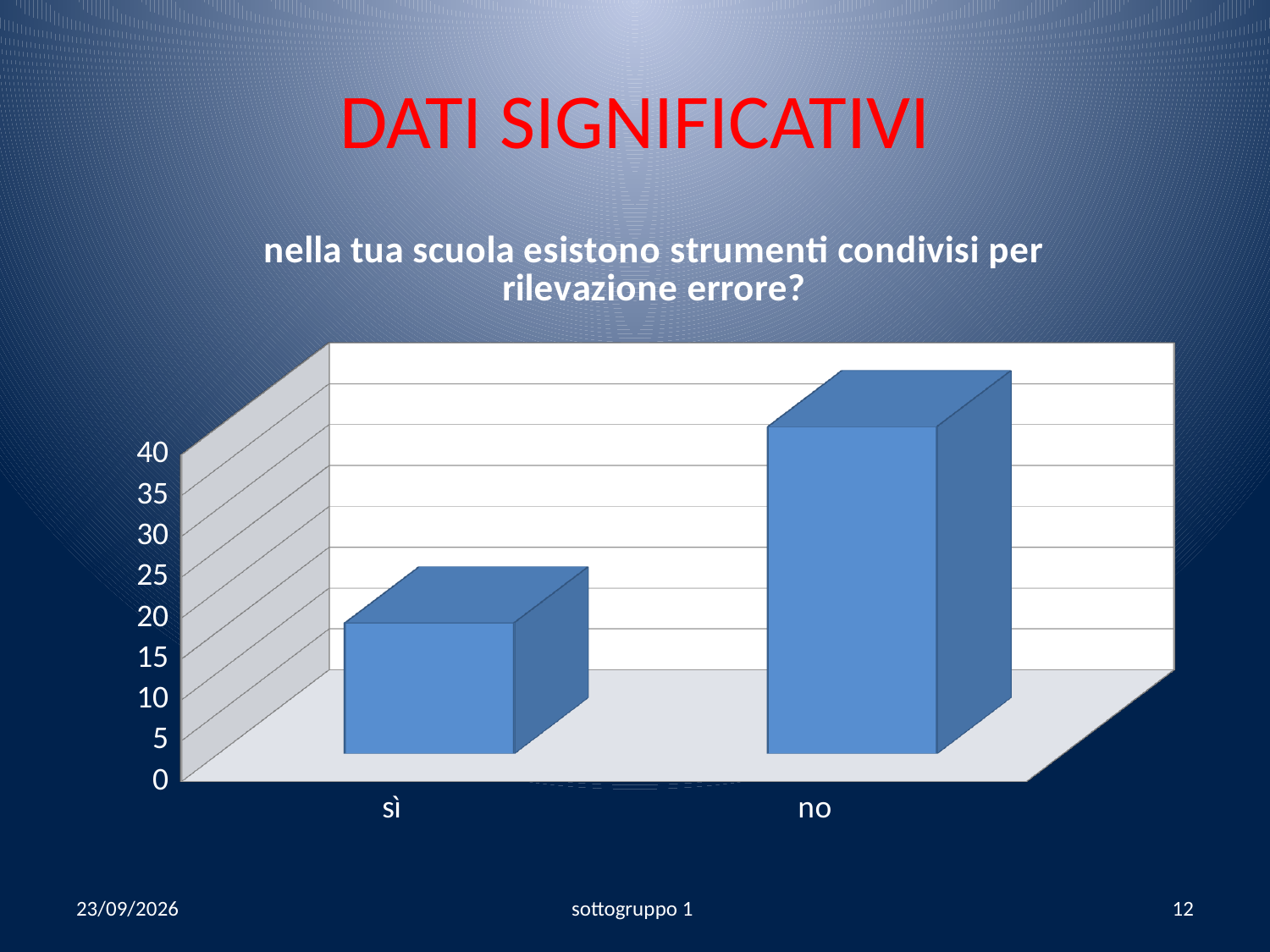
Which category has the highest bar in the chart? no What is the highest value shown on the vertical axis of the chart? 40 Is the value for "sì" greater or less than 25? less Is the value for "no" greater or less than 25? greater Is the value for "no" greater or less than 30? greater What kind of chart is shown on the slide? bar chart Do the bar values rise or fall from left to right along the x axis? rise How many categories are shown on the x axis of the chart? 2 Which category has the lowest bar in the chart? sì What is the title of the chart? nella tua scuola esistono strumenti condivisi per rilevazione errore? Which is larger, the value for "sì" or the value for "no"? no